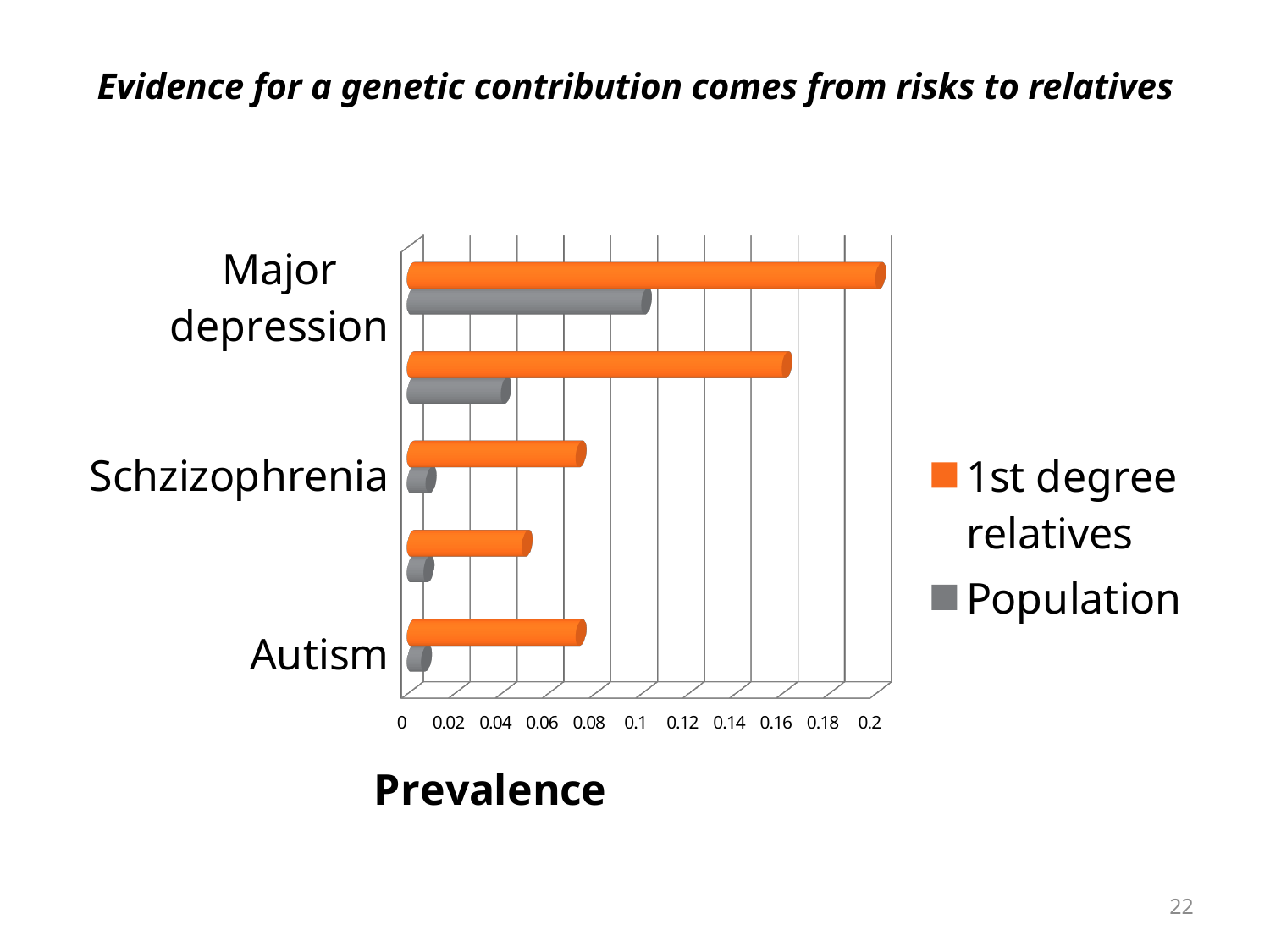
For Schizophrenia, which series has the larger value: 1st degree relatives or Population? 1st degree relatives How many series does the legend list? 2 What kind of chart is shown on the slide? Bar chart What is the label of the horizontal axis? Prevalence Is the 1st degree relatives value for Autism greater or less than 0.1? less Which labeled category has the highest value for 1st degree relatives? Major depression Which is larger for 1st degree relatives: Major depression or Autism? Major depression Is the Population value for Major depression greater or less than 0.08? greater Is the 1st degree relatives value for Schizophrenia greater or less than 0.1? less Which series is shown in orange? 1st degree relatives